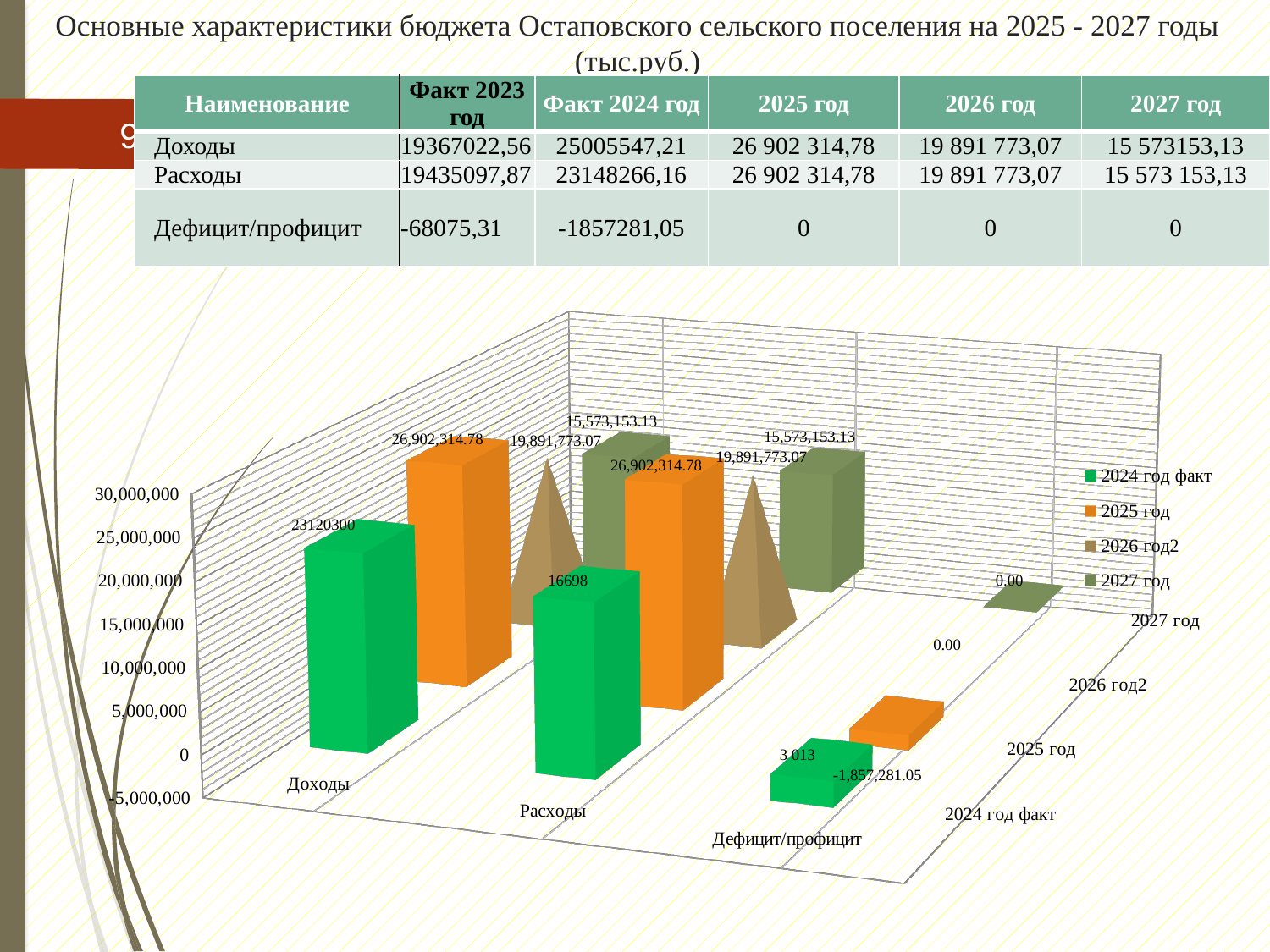
What kind of chart is shown on the slide? bar chart How many series does the chart legend list? 4 For Доходы, which is larger: the 2025 год value or the 2027 год value? 2025 год What is the value of Дефицит/профицит for the 2027 год series in the chart? 0.00 Is the Доходы value for the 2024 год факт series greater or less than 20,000,000? greater How many categories are shown along the category axis of the chart? 3 What is the value of Расходы for the 2026 год2 series in the chart? 19,891,773.07 Which series has the highest value for Доходы in the chart? 2025 год What is the value of Дефицит/профицит for the 2025 год series in the chart? -1,857,281.05 What is the value of Доходы for the 2025 год series in the chart? 26,902,314.78 What is the value of Доходы for the 2027 год series in the chart? 15,573,153.13 What is the difference between the Доходы value for 2025 год and the Доходы value for 2027 год? 11,329,161.65